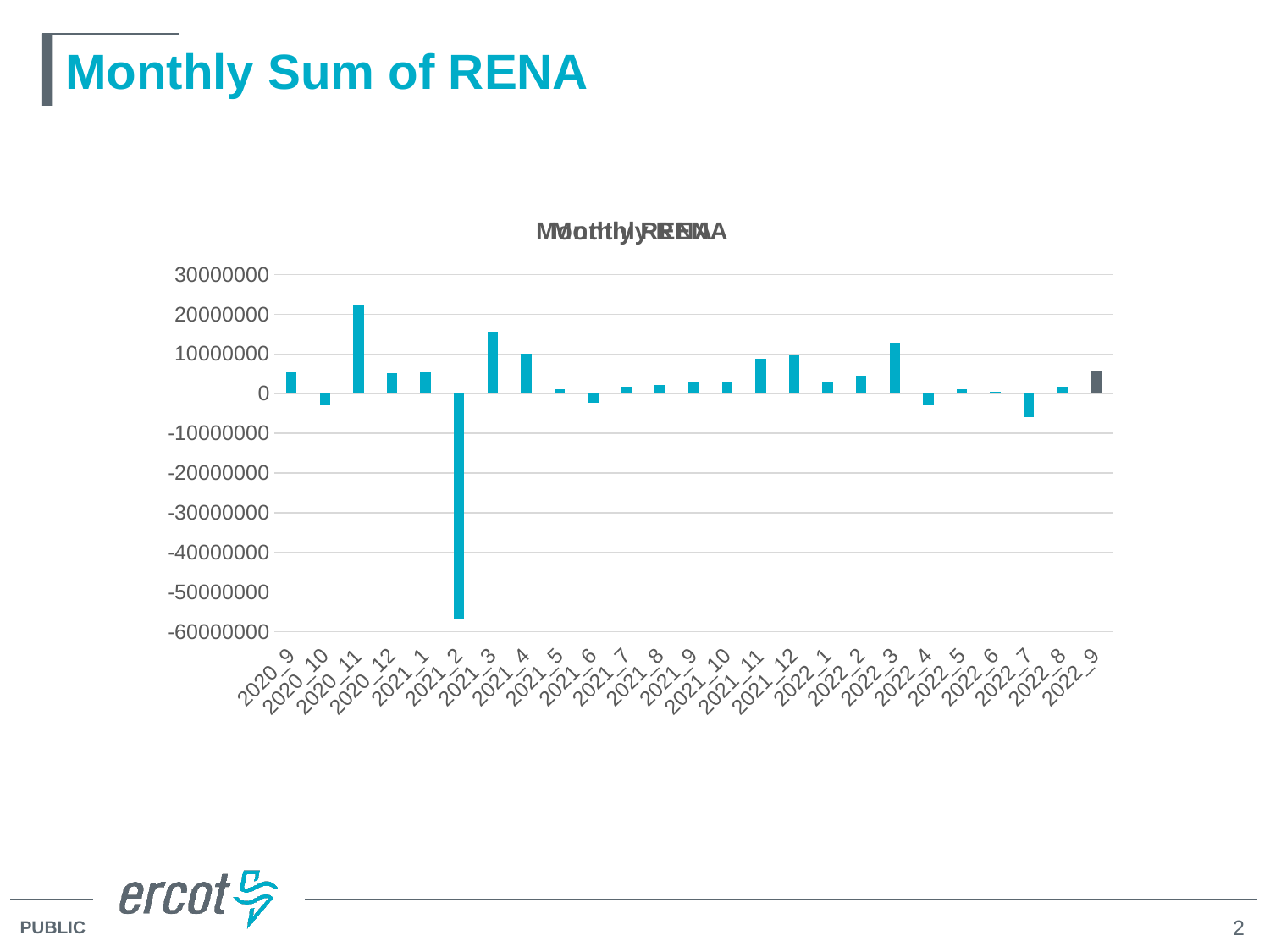
What is the lowest value shown on the y axis? -60000000 Is the value for 2022_7 greater or less than 0? less Which month's bar is drawn in a different colour (dark grey) from the rest? 2022_9 Is the value for 2021_2 greater or less than -50000000? less Which is larger, the value for 2022_3 or the value for 2022_4? 2022_3 What kind of chart is shown on the slide? bar chart Which month has the highest value? 2020_11 Is the value for 2021_3 greater or less than 10000000? greater Which month has the lowest value? 2021_2 How many monthly categories are plotted along the x axis? 25 Which is larger, the value for 2020_11 or the value for 2021_3? 2020_11